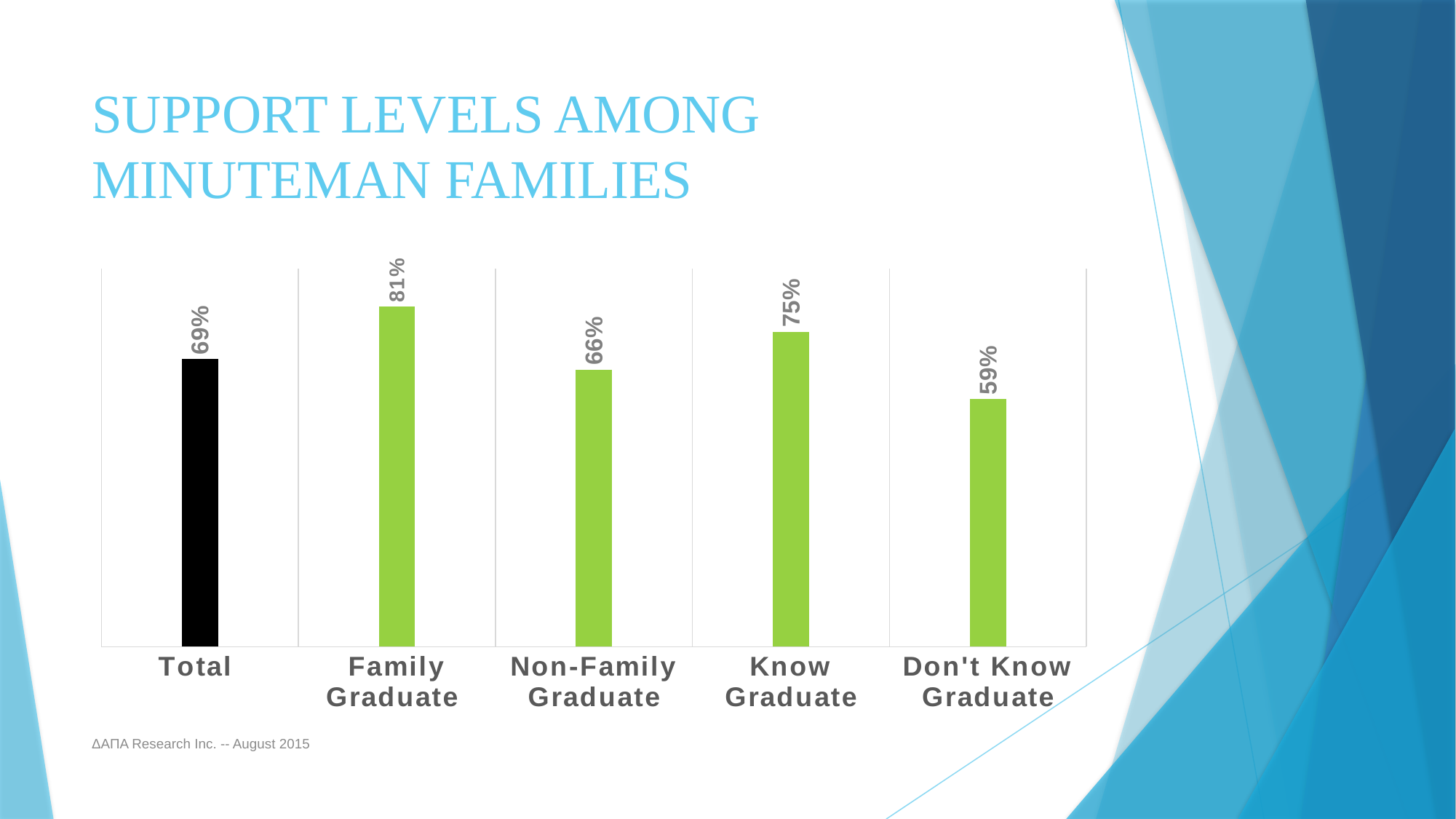
Which category has the lowest value? Don't Know Graduate How many categories are shown in the chart? 5 What is the value for Non-Family Graduate? 66% What is the value for Total? 69% Which is larger, the value for Know Graduate or the value for Total? Know Graduate Which category has the highest value? Family Graduate What colour is the bar for Total? Black What is the value for Don't Know Graduate? 59% What is the value for Know Graduate? 75% What is the value for Family Graduate? 81% What is the difference between the values for Family Graduate and Non-Family Graduate? 15% What kind of chart is shown on the slide? Bar chart